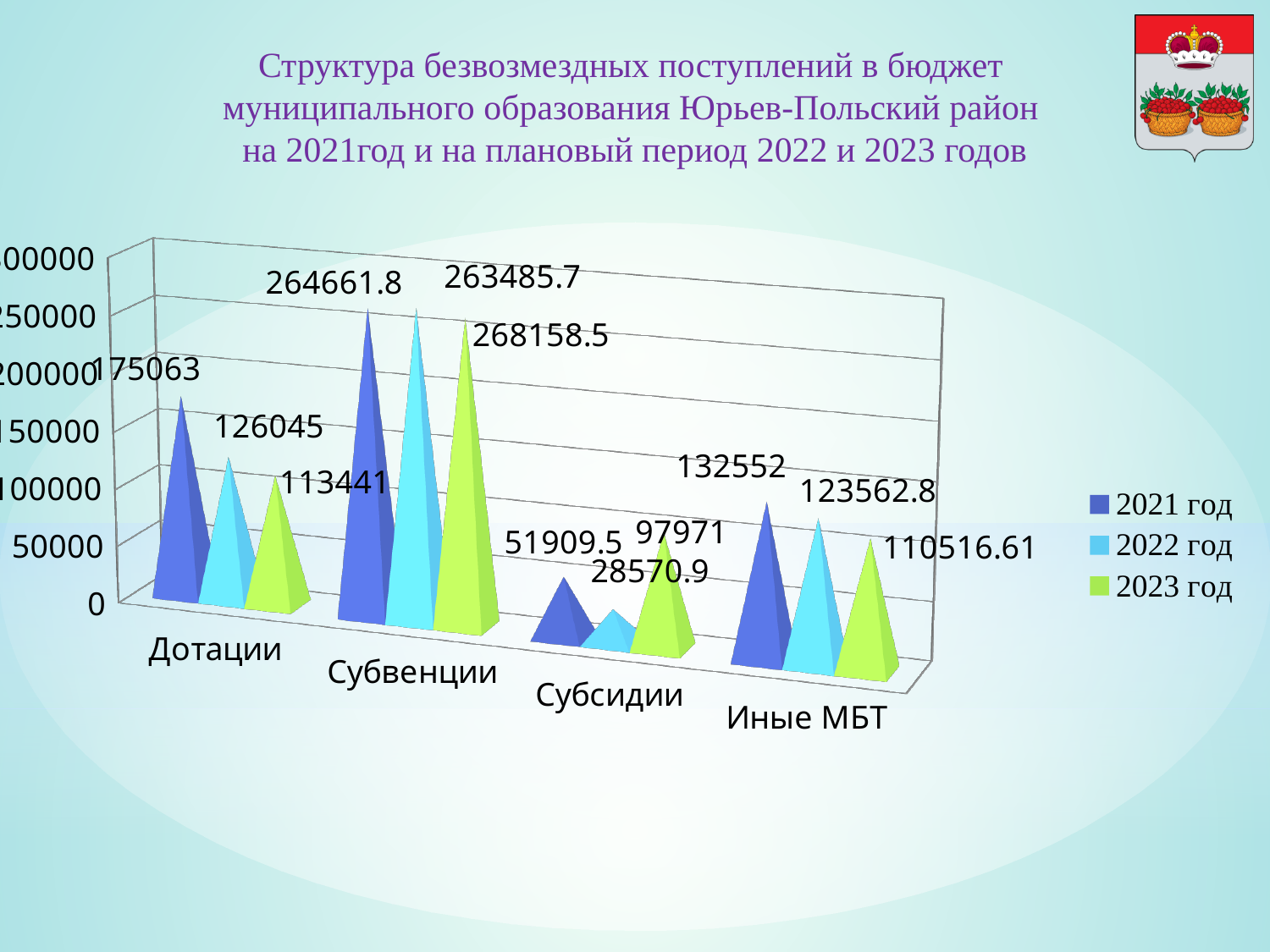
What is the value for Иные МБТ in the 2023 год series? 110516.61 Which is larger for Субсидии: the 2021 год value or the 2023 год value? 2023 год Which category has the highest value in the 2021 год series? Субвенции How many categories are shown on the x axis? 4 What is the value for Субвенции in the 2023 год series? 263485.7 Which colour represents the 2023 год series in the legend? green What is the value for Дотации in the 2021 год series? 175063 What is the value for Субсидии in the 2022 год series? 28570.9 What is the difference between the 2021 год and 2023 год values for Дотации? 61622 How many series does the legend list? 3 What kind of chart is shown on the slide? bar chart Which category has the lowest value in the 2022 год series? Субсидии